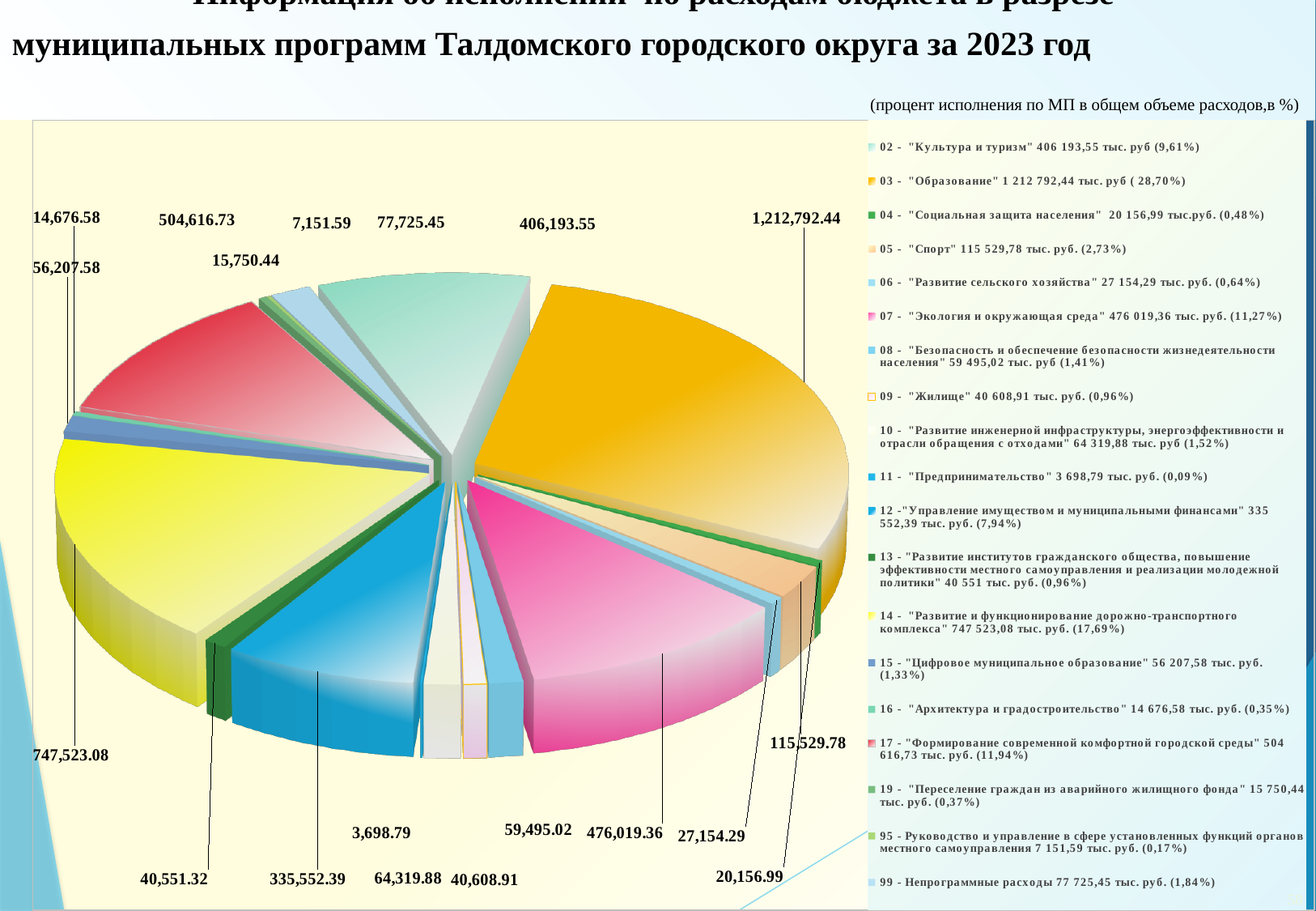
What is the name of legend entry 99? Непрограммные расходы Which municipal program has the largest slice of the pie? 03 - "Образование" What kind of chart is shown on the slide? pie chart How many slices (programs) does the pie chart contain? 19 What share of total expenditure does "Экология и окружающая среда" (07) account for, according to the legend? 11,27% Which municipal program has the smallest slice of the pie? 11 - "Предпринимательство" What share of total expenditure does "Образование" (03) account for, according to the legend? 28,70% What is the value shown for "Спорт" (05)? 115,529.78 What is the difference between the value for "Образование" (1,212,792.44) and the value for "Развитие и функционирование дорожно-транспортного комплекса" (747,523.08)? 465,269.36 What is the value shown for "Развитие и функционирование дорожно-транспортного комплекса" (14)? 747,523.08 What is the value shown for "Культура и туризм" (02)? 406,193.55 Which is larger: the value for "Экология и окружающая среда" (07) or for "Формирование современной комфортной городской среды" (17)? "Формирование современной комфортной городской среды" (17)